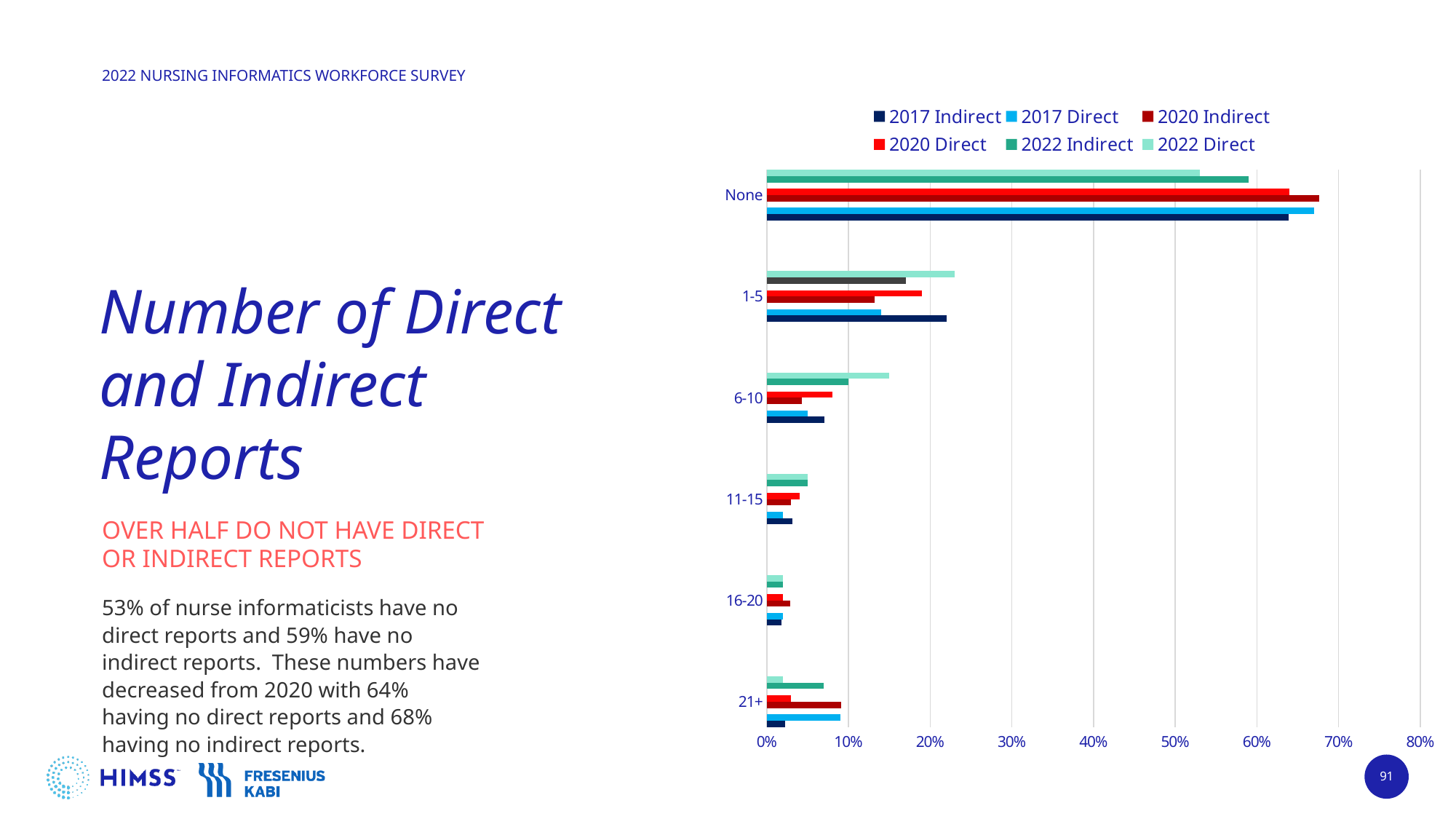
What is the 2022 Indirect value for the None category? 59% For the 1-5 category, which is larger: 2017 Indirect or 2017 Direct? 2017 Indirect How many categories are shown on the vertical axis of the chart? 6 What is the 2022 Direct value for the None category? 53% For the 6-10 category, which is larger: 2022 Direct or 2022 Indirect? 2022 Direct How many series does the legend list? 6 What is the 2020 Indirect value for the None category? 68% Is the 2017 Indirect value for None greater or less than 60%? greater Is the 2022 Direct value for 1-5 greater or less than 20%? greater What kind of chart is shown on the slide? bar chart Is the 2020 Indirect value for 21+ greater or less than 10%? less Which category has the highest values across all series? None